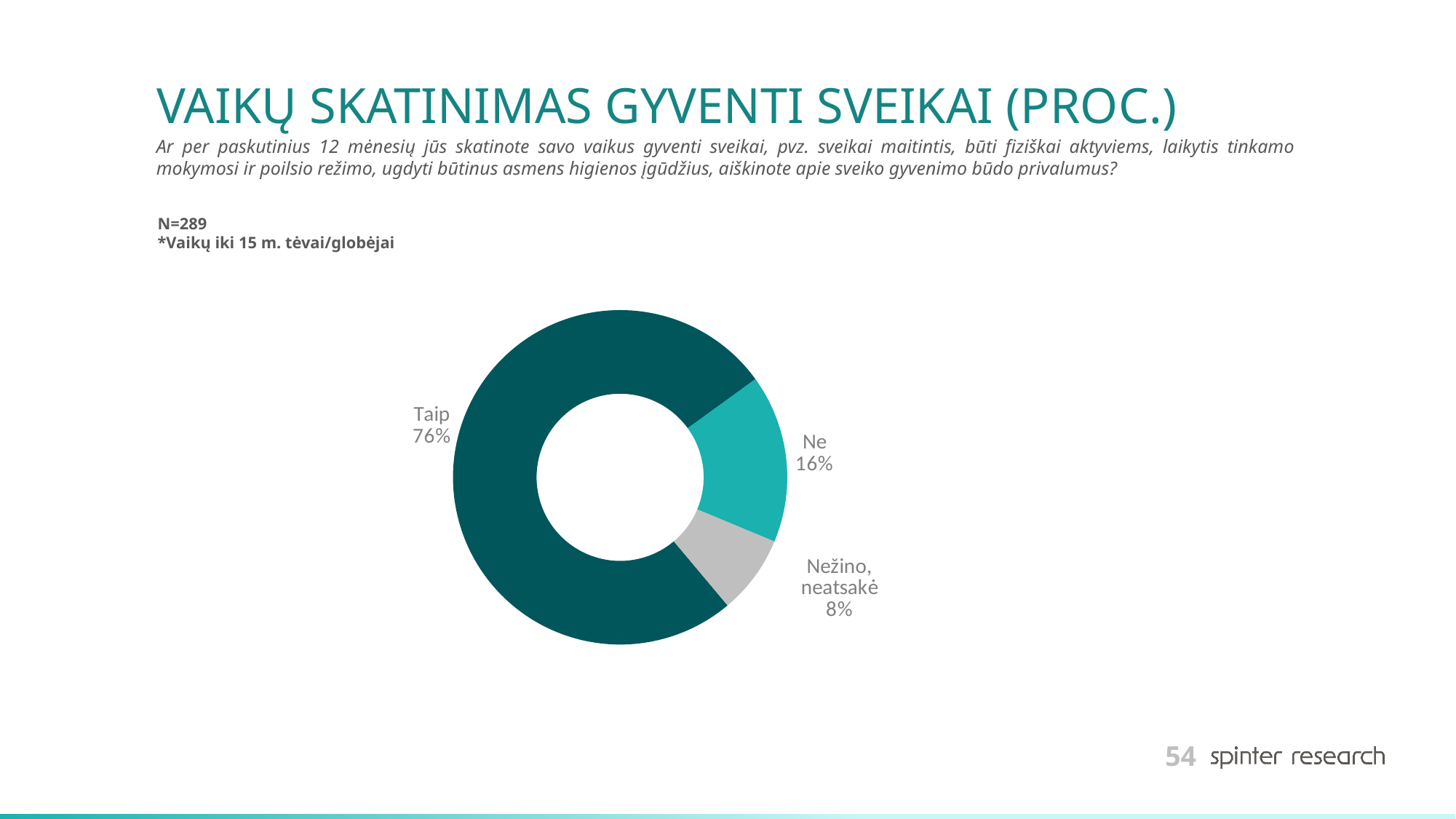
What kind of chart is shown on the slide? Doughnut (pie) chart How many categories are shown in the chart? 3 What is the difference in percentage points between "Taip" and "Ne"? 60 What is the difference in percentage points between "Ne" and "Nežino, neatsakė"? 8 Which category has the smallest share of the chart? Nežino, neatsakė What is the sample size (N) stated on the slide? N=289 Which category has the largest share of the chart? Taip What percentage of respondents answered "Ne"? 16% What percentage of respondents answered "Taip"? 76% What is the title of the slide? VAIKŲ SKATINIMAS GYVENTI SVEIKAI (PROC.) Which is larger, the share for "Ne" or the share for "Nežino, neatsakė"? Ne What percentage of respondents answered "Nežino, neatsakė"? 8%